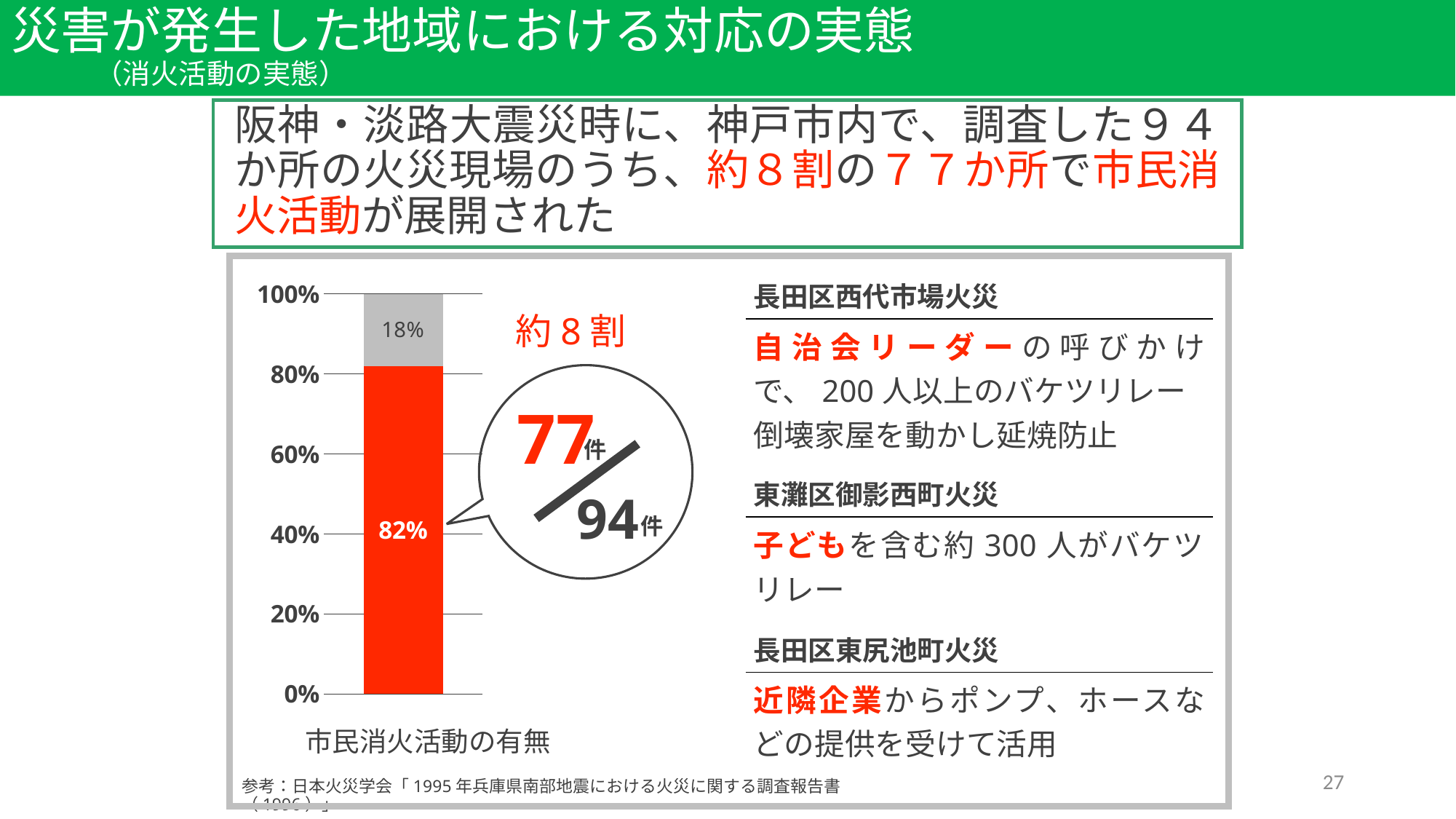
グラフの縦軸の最大目盛りはいくつですか？ 100% 積み上げ棒グラフの赤い部分の値はいくつですか？ 82% 積み上げ棒の合計は何%ですか？ 100% 赤い部分と灰色の部分では、どちらの値が大きいですか？ 赤い部分 グラフに描かれている棒（カテゴリ）はいくつありますか？ 1 赤い部分と灰色の部分の値の差は何ポイントですか？ 64ポイント 灰色の部分の値は20%より大きいですか、小さいですか？ 小さい 赤い部分の値は60%より大きいですか、小さいですか？ 大きい 積み上げ棒はいくつの部分に分かれていますか？ 2 グラフの横軸に書かれているラベルは何ですか？ 市民消火活動の有無 このグラフはどの種類のグラフですか？ 積み上げ棒グラフ 積み上げ棒グラフの灰色の部分の値はいくつですか？ 18%